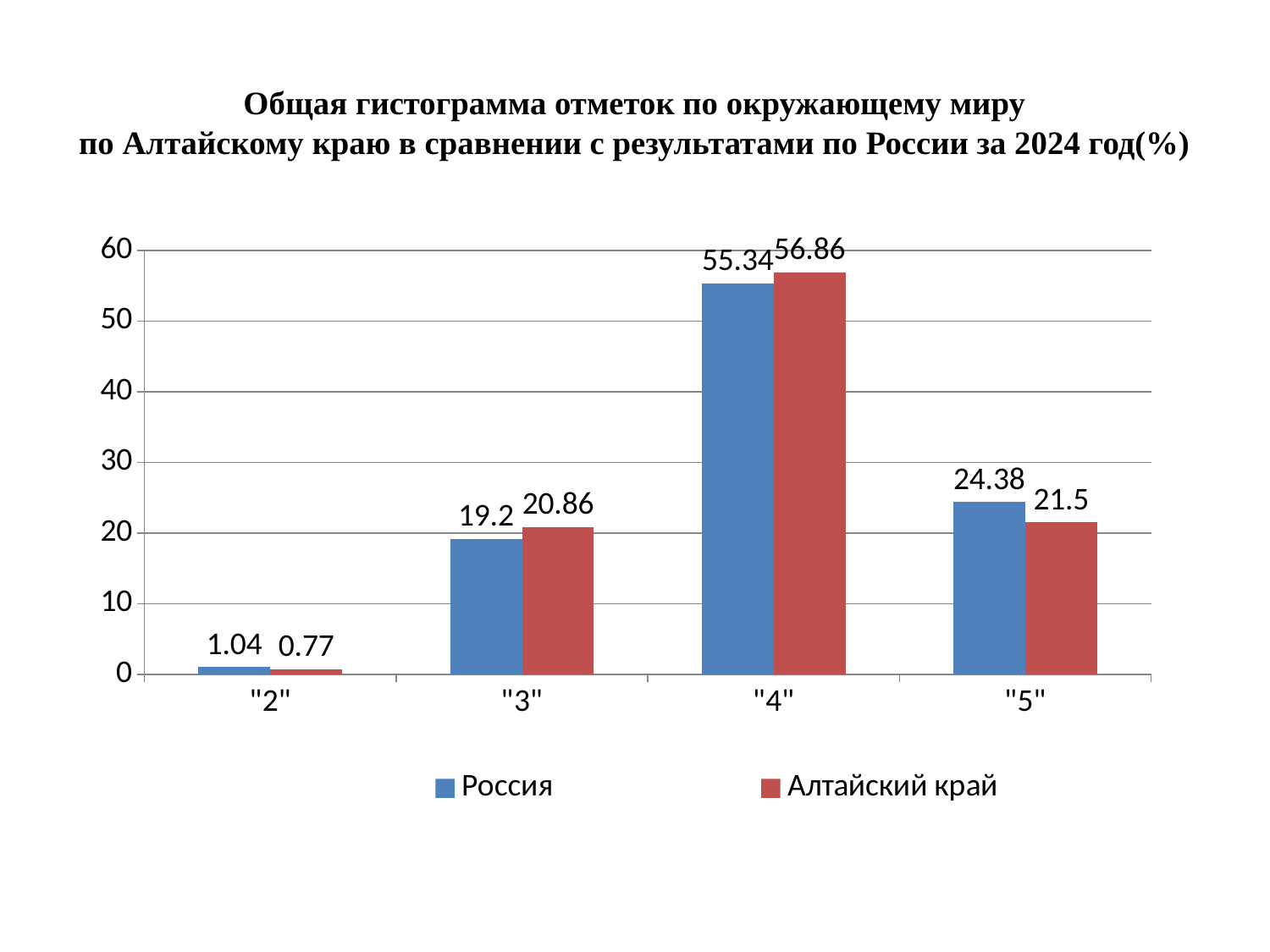
What is the value for Алтайский край for grade "2"? 0.77 Which is larger for grade "3": Россия or Алтайский край? Алтайский край What is the value for Алтайский край for grade "3"? 20.86 Is the value for Россия for grade "5" greater or less than 20? greater Which grade has the lowest value for Россия? "2" How many series does the legend list? 2 What kind of chart is shown on the slide? bar chart Which grade has the highest value for Алтайский край? "4" How many grade categories are shown on the x axis? 4 What is the difference between Россия and Алтайский край for grade "5"? 2.88 What is the value for Россия for grade "4"? 55.34 Which colour represents Россия in the chart? blue